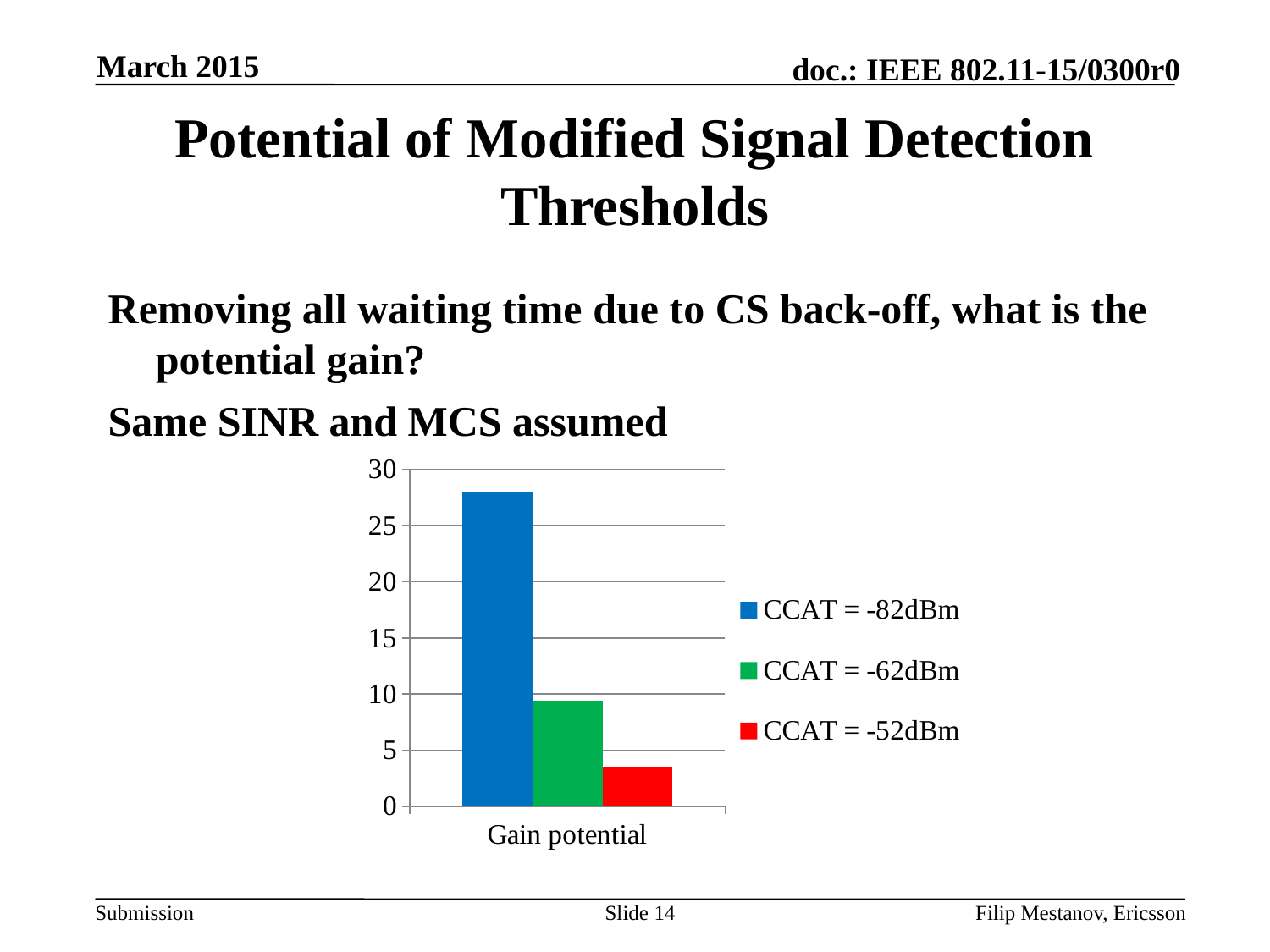
Is the value for CCAT = -82dBm greater or less than 25? greater How many series does the legend list? 3 Which is larger, the value for CCAT = -62dBm or the value for CCAT = -52dBm? CCAT = -62dBm What is the label of the category on the x axis? Gain potential How many categories are shown on the x axis? 1 Is the value for CCAT = -82dBm greater or less than 30? less What colour is the bar for CCAT = -52dBm? red What kind of chart is shown on the slide? bar chart Which series has the lowest value for Gain potential? CCAT = -52dBm Which series has the highest value for Gain potential? CCAT = -82dBm Is the value for CCAT = -52dBm greater or less than 5? less